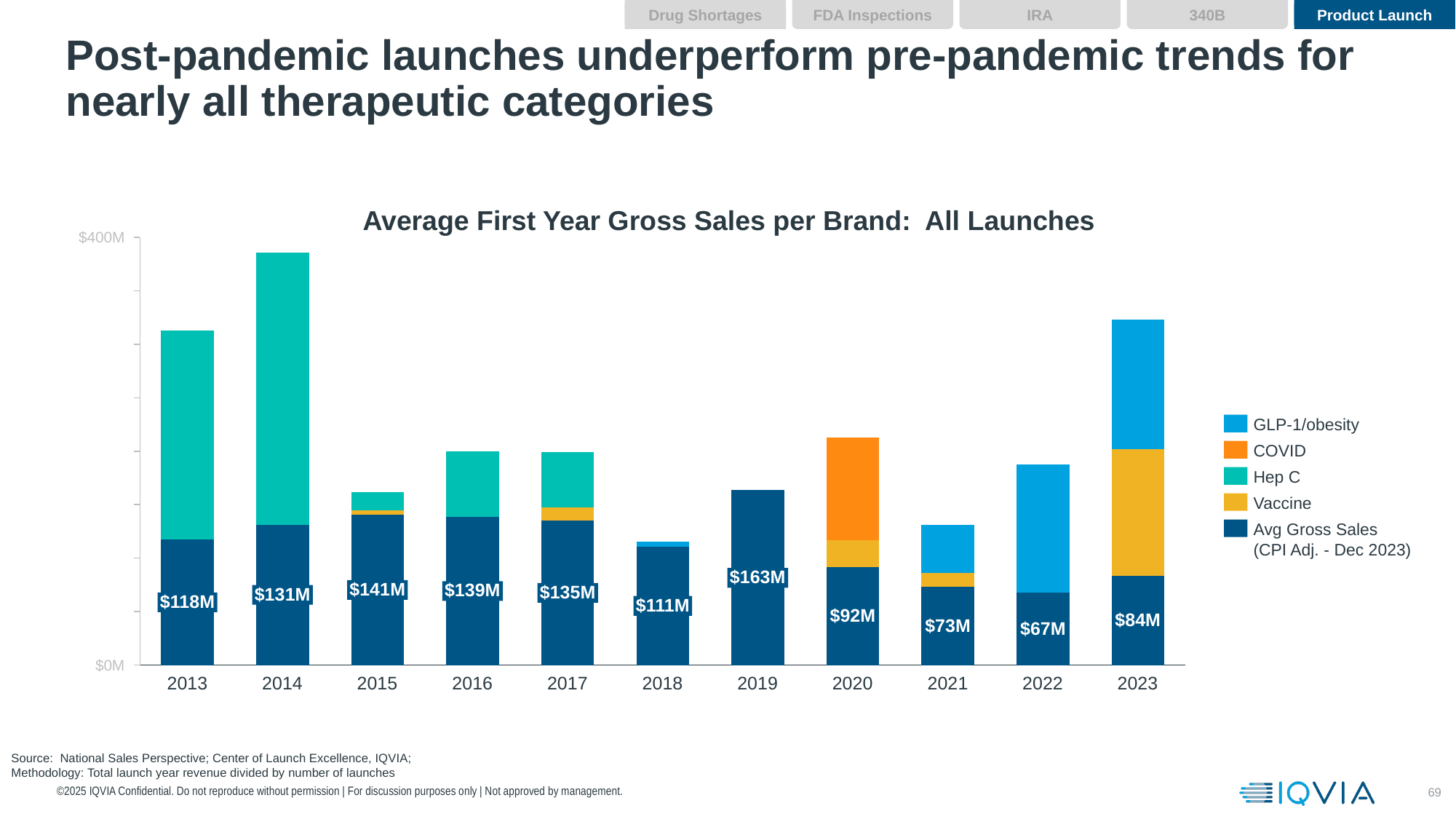
Which year has the larger Avg Gross Sales value, 2015 or 2021? 2015 Which year has the highest labeled Avg Gross Sales (CPI Adj. - Dec 2023) value? 2019 What kind of chart is shown on the slide? Stacked bar chart How many series does the legend list? 5 What is the difference between the Avg Gross Sales values for 2019 and 2022? $96M How many years are shown on the x axis of the chart? 11 Is the total stacked bar for 2023 greater or less than $400M? less What is the Avg Gross Sales (CPI Adj. - Dec 2023) value for 2022? $67M What is the Avg Gross Sales (CPI Adj. - Dec 2023) value for 2019? $163M Which series is shown in orange in the legend? COVID Which year has the lowest labeled Avg Gross Sales (CPI Adj. - Dec 2023) value? 2022 What is the Avg Gross Sales (CPI Adj. - Dec 2023) value for 2013? $118M